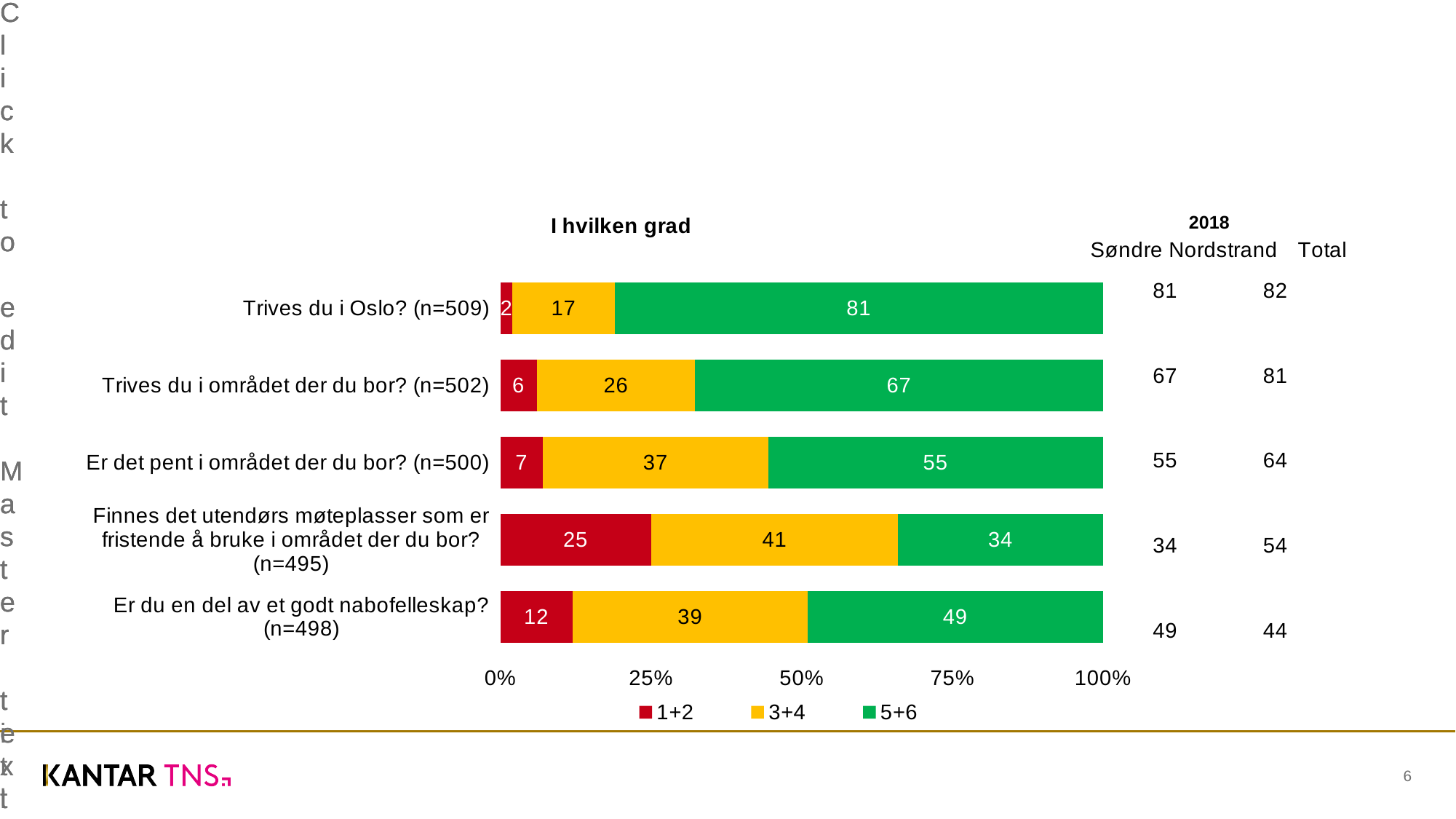
How many series does the legend list? 3 What is the difference between the 5+6 values for "Trives du i Oslo? (n=509)" and "Trives du i området der du bor? (n=502)"? 14 How many categories (questions) are shown in the chart? 5 What is the total of the stacked bar for "Er du en del av et godt nabofelleskap? (n=498)"? 100 Which is larger: the 3+4 value for "Er du en del av et godt nabofelleskap? (n=498)" or the 3+4 value for "Trives du i området der du bor? (n=502)"? Er du en del av et godt nabofelleskap? (n=498) What is the value of the 1+2 series for "Finnes det utendørs møteplasser som er fristende å bruke i området der du bor? (n=495)"? 25 Which category has the highest 5+6 value? Trives du i Oslo? (n=509) What is the title of the chart? I hvilken grad Which category has the lowest 1+2 value? Trives du i Oslo? (n=509) What kind of chart is shown on the slide? Stacked bar chart What is the value of the 5+6 series for "Trives du i Oslo? (n=509)"? 81 What is the value of the 3+4 series for "Er det pent i området der du bor? (n=500)"? 37